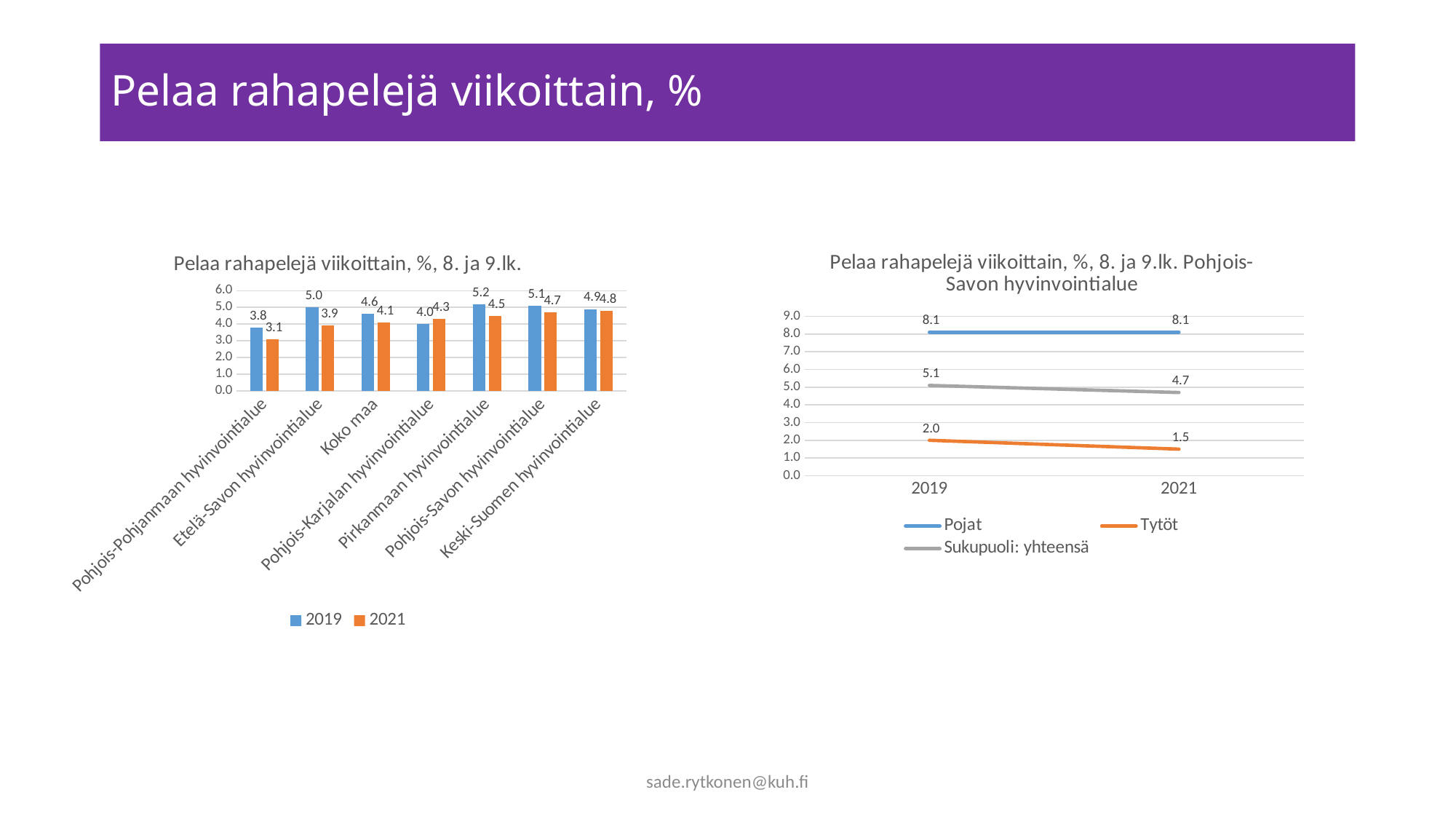
What type of chart is the left chart 'Pelaa rahapelejä viikoittain, %, 8. ja 9.lk.'? Bar chart In the right chart for Pohjois-Savon hyvinvointialue, what is the value for Pojat in 2019? 8.1 In the left chart 'Pelaa rahapelejä viikoittain, %, 8. ja 9.lk.', is the 2019 or the 2021 value larger for Pohjois-Karjalan hyvinvointialue? 2021 In the left chart 'Pelaa rahapelejä viikoittain, %, 8. ja 9.lk.', what is the difference between the 2019 and 2021 values for Etelä-Savon hyvinvointialue? 1.1 In the right chart for Pohjois-Savon hyvinvointialue, does the 'Sukupuoli: yhteensä' line rise or fall from 2019 to 2021? Fall How many series does the legend of the right chart for Pohjois-Savon hyvinvointialue list? 3 How many categories are shown on the x axis of the left chart 'Pelaa rahapelejä viikoittain, %, 8. ja 9.lk.'? 7 In the left chart 'Pelaa rahapelejä viikoittain, %, 8. ja 9.lk.', what is the 2021 value for Koko maa? 4.1 In the left chart 'Pelaa rahapelejä viikoittain, %, 8. ja 9.lk.', which category has the highest 2019 value? Pirkanmaan hyvinvointialue In the left chart 'Pelaa rahapelejä viikoittain, %, 8. ja 9.lk.', what is the 2019 value for Etelä-Savon hyvinvointialue? 5.0 In the left chart 'Pelaa rahapelejä viikoittain, %, 8. ja 9.lk.', which category has the lowest 2021 value? Pohjois-Pohjanmaan hyvinvointialue In the right chart for Pohjois-Savon hyvinvointialue, what is the value for Tytöt in 2021? 1.5